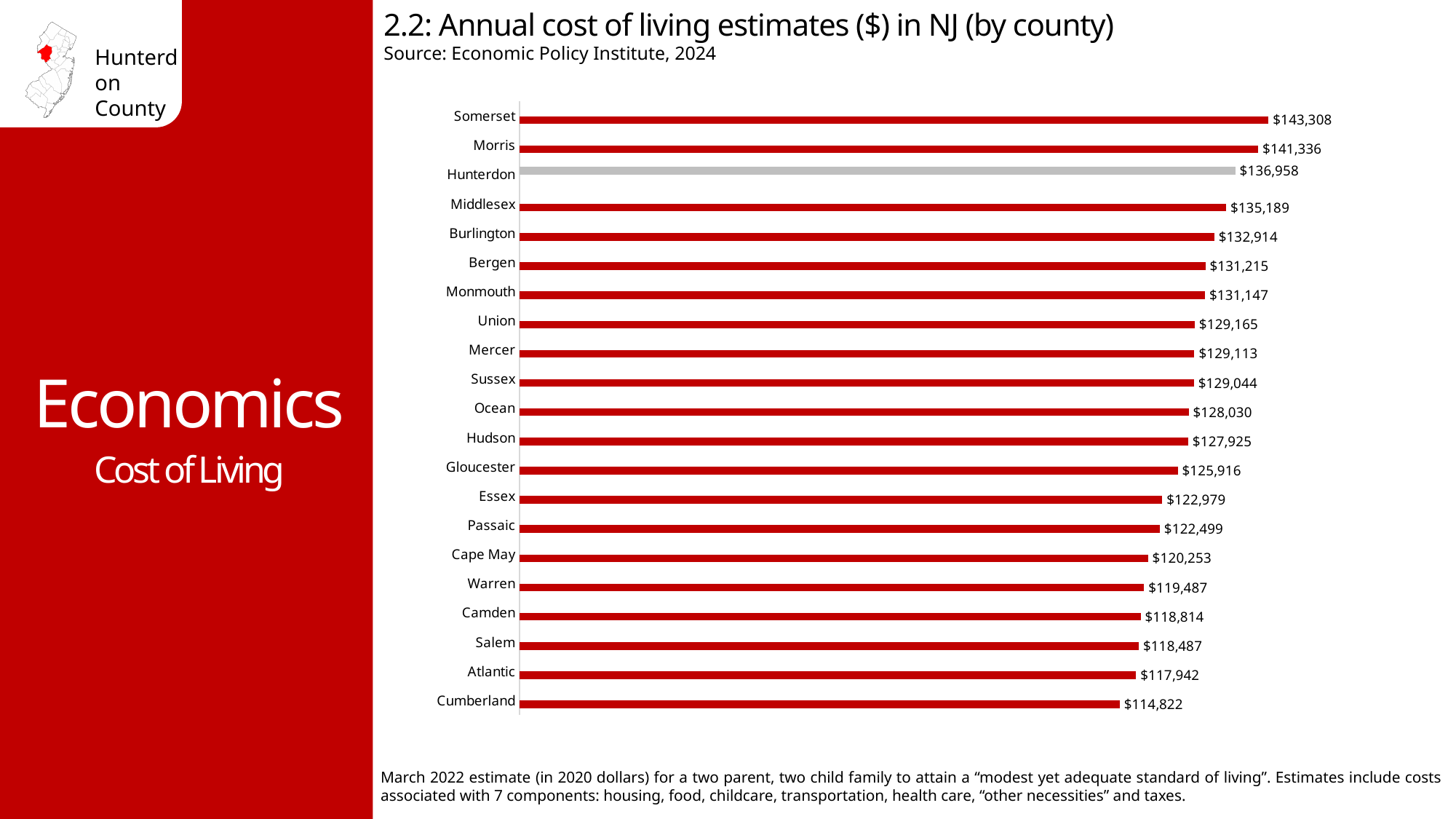
What is the annual cost of living estimate for Hunterdon County? $136,958 Which county has the highest annual cost of living estimate? Somerset Which county's bar is shown in gray instead of red? Hunterdon What kind of chart is shown on the slide? Bar chart What is the annual cost of living estimate for Bergen County? $131,215 What is the difference between the cost of living estimates for Morris and Hunterdon? $4,378 What is the annual cost of living estimate for Cape May County? $120,253 Which county has the lowest annual cost of living estimate? Cumberland How many counties are shown in the chart? 21 What is the difference between the cost of living estimates for Somerset and Cumberland? $28,486 Which county has a higher cost of living estimate, Middlesex or Essex? Middlesex What is the source cited for the chart? Economic Policy Institute, 2024